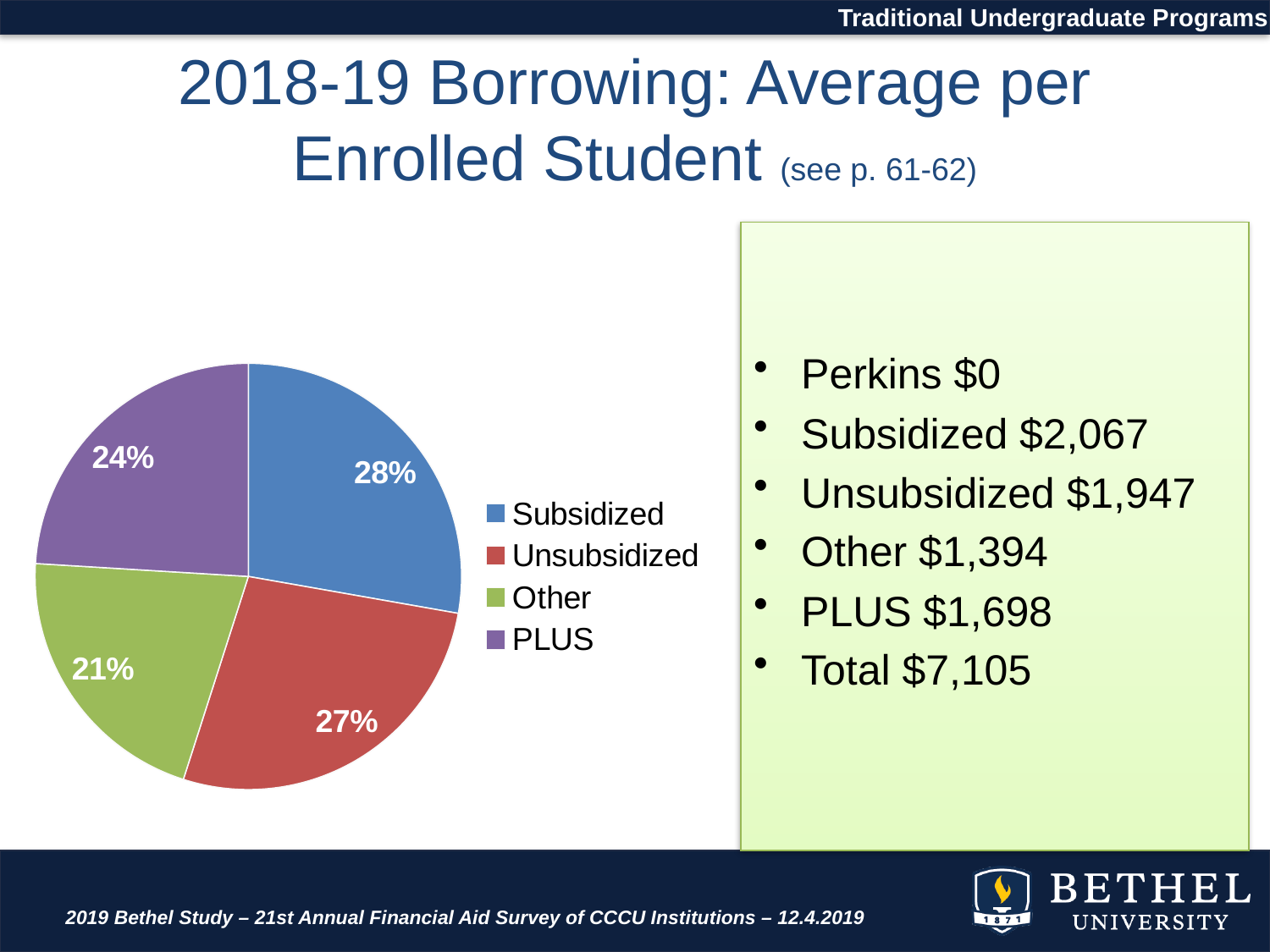
What colour is the Other slice in the pie chart? green Which slice of the pie is the smallest? Other What is the difference in percentage points between the PLUS slice and the Other slice? 3% What kind of chart is shown on the slide? pie chart How many entries does the legend list? 4 How many slices does the pie chart have? 4 What share of the pie does the Other slice represent? 21% What share of the pie does the PLUS slice represent? 24% What share of the pie does the Subsidized slice represent? 28% Which slice is larger, Unsubsidized or PLUS? Unsubsidized Which slice of the pie is the largest? Subsidized